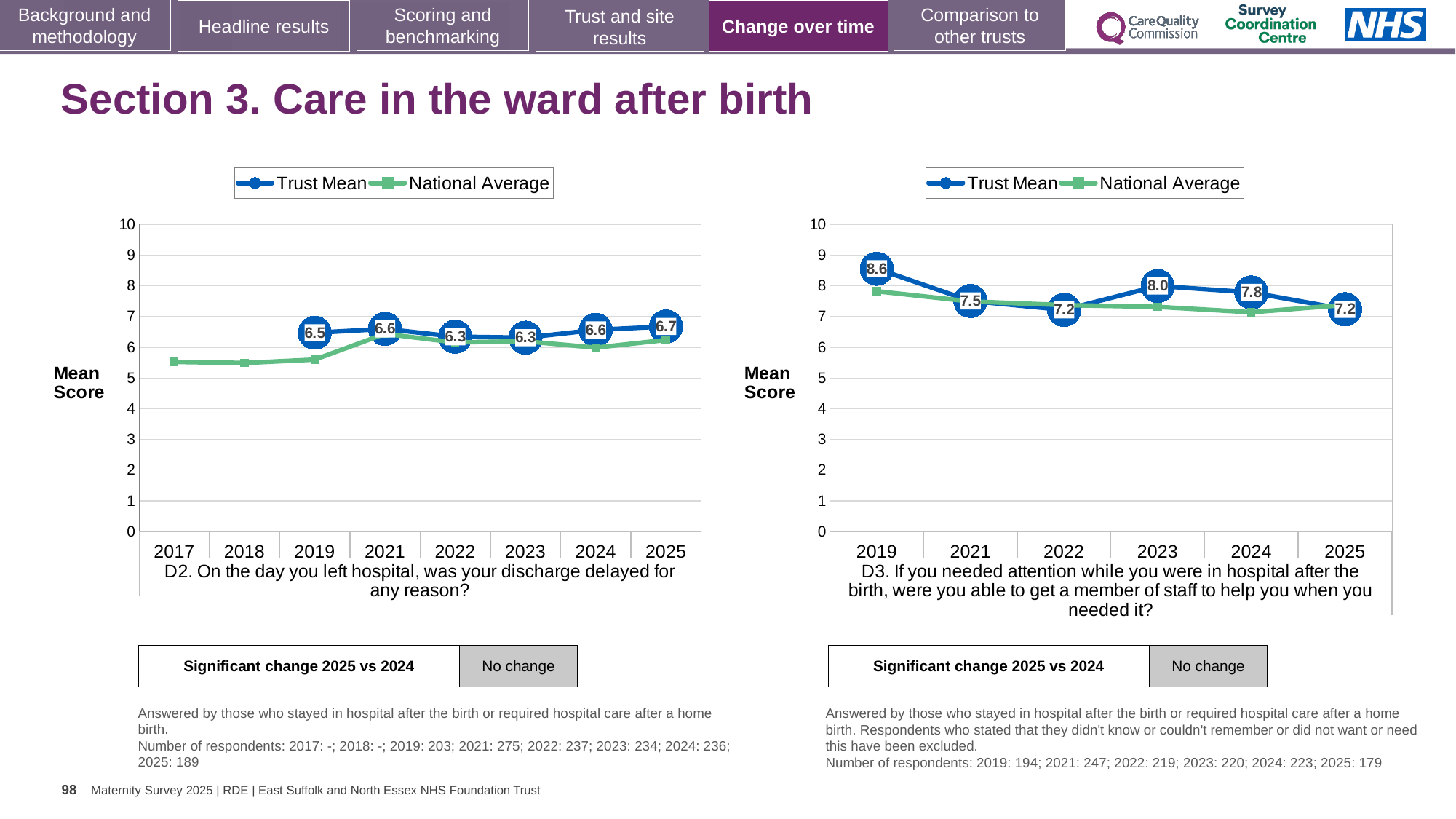
In the D2 chart on the left, what is the difference between the Trust Mean for 2025 and the Trust Mean for 2022? 0.4 In the D2 chart on the left, what is the Trust Mean for 2025? 6.7 In the D3 chart on the right, what is the difference between the Trust Mean for 2019 and the Trust Mean for 2025? 1.4 What kind of chart is the D3 chart on the right? line chart How many years are shown on the x axis of the D2 chart on the left? 8 In the D2 chart on the left, is the National Average for 2017 greater or less than 6? less In the D3 chart on the right, which year has the highest Trust Mean? 2019 In the D3 chart on the right, what is the Trust Mean for 2023? 8.0 How many series does the legend of the D3 chart on the right list? 2 In the D3 chart on the right, which is larger: the Trust Mean for 2023 or the Trust Mean for 2024? 2023 In the D2 chart on the left, which year has the highest Trust Mean? 2025 In the D3 chart on the right, what is the Trust Mean for 2019? 8.6